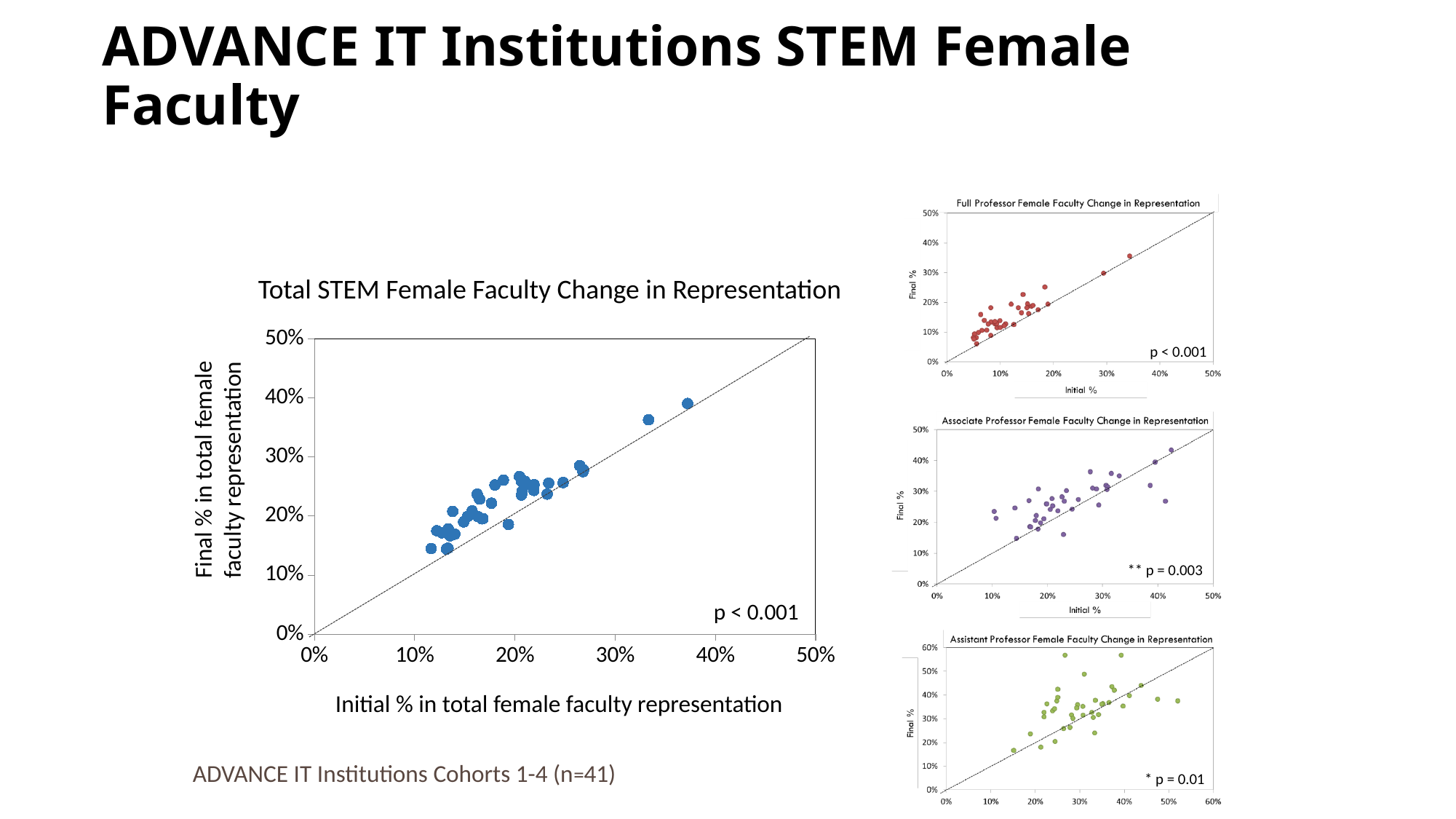
In the 'Associate Professor Female Faculty Change in Representation' chart, what p-value is printed on the chart? p = 0.003 How many charts are shown on the slide? 4 According to the slide, how many ADVANCE IT institutions (n) are included in the data? 41 In the 'Total STEM Female Faculty Change in Representation' chart, what p-value is printed on the chart? p < 0.001 What kind of chart is the 'Total STEM Female Faculty Change in Representation' chart? scatter plot In the 'Assistant Professor Female Faculty Change in Representation' chart, what p-value is printed on the chart? p = 0.01 In the 'Total STEM Female Faculty Change in Representation' chart, is the final % of the point with the highest initial % greater or less than 30%? greater In the 'Total STEM Female Faculty Change in Representation' chart, what is the maximum value shown on the y axis? 50% In the 'Assistant Professor Female Faculty Change in Representation' chart, what is the maximum value shown on the x axis? 60% In the 'Full Professor Female Faculty Change in Representation' chart, what p-value is printed on the chart? p < 0.001 In the 'Total STEM Female Faculty Change in Representation' chart, what is the label of the x axis? Initial % in total female faculty representation